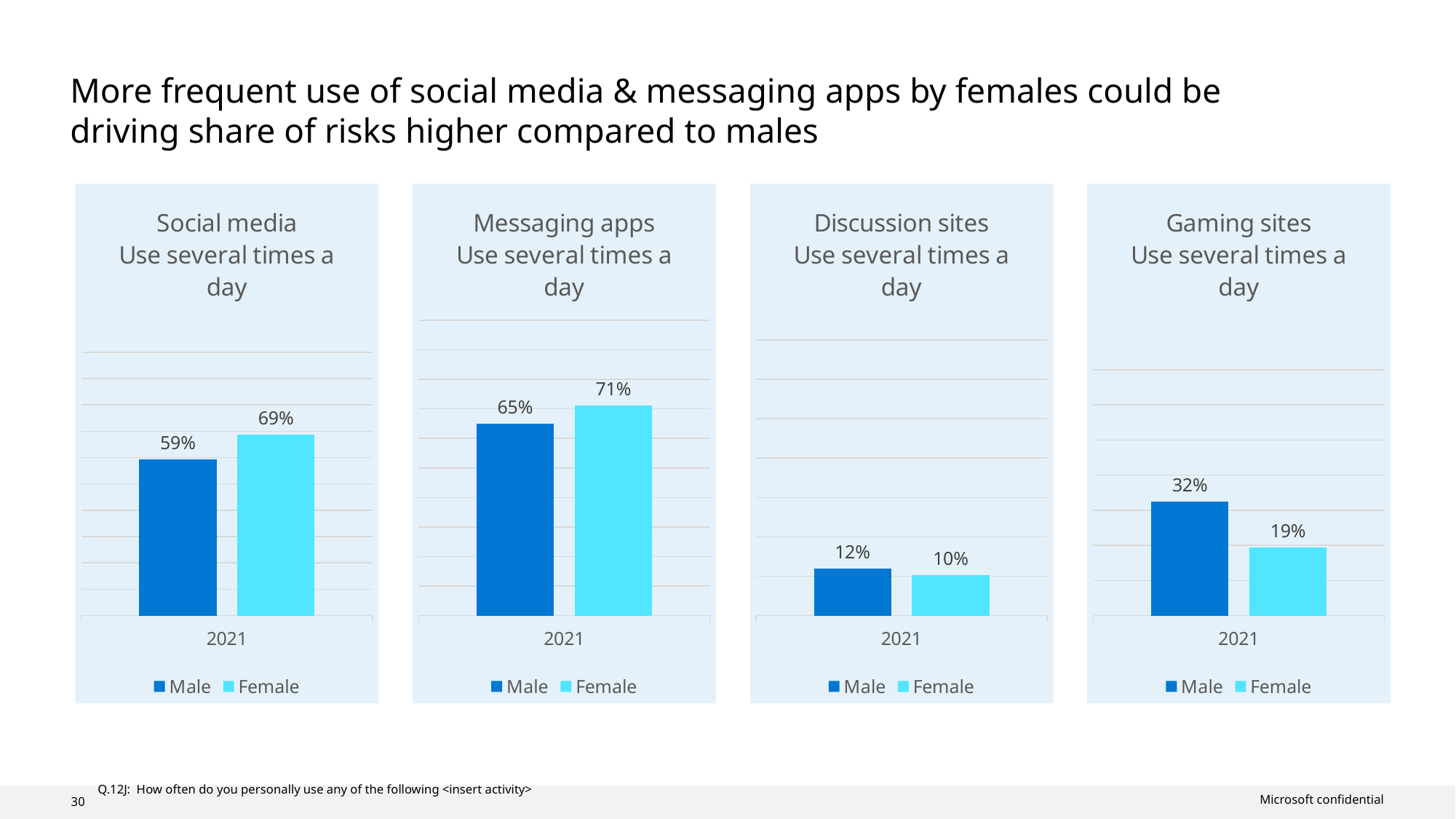
In the Discussion sites chart, which series has the lowest value? Female In the Gaming sites chart, which series has the higher value, Male or Female? Male In the Social media chart, what is the value for Female in 2021? 69% In the Messaging apps chart, which series has the higher value, Male or Female? Female How many charts are shown on the slide? 4 In the Social media chart, what is the difference between the Female and Male values? 10% How many series does the legend of the Social media chart list? 2 In the Discussion sites chart, what is the value for Female in 2021? 10% In the Gaming sites chart, what is the value for Male in 2021? 32% In the Gaming sites chart, what is the difference between the Male and Female values? 13% What kind of chart is the Messaging apps chart? Bar chart In the Messaging apps chart, what is the value for Male in 2021? 65%